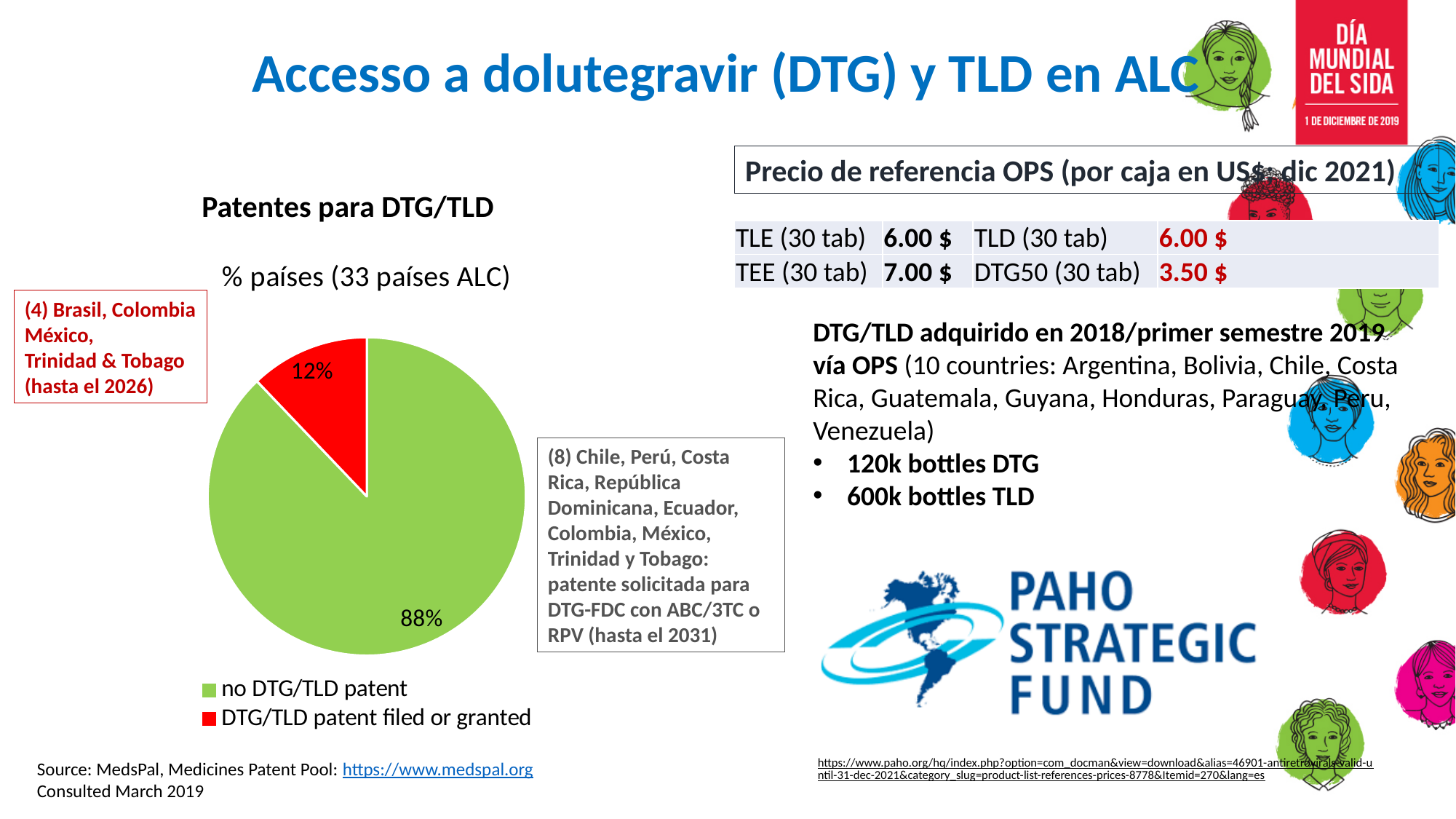
What share of the pie does the 'DTG/TLD patent filed or granted' slice represent? 12% What is the difference in percentage points between the 'no DTG/TLD patent' slice and the 'DTG/TLD patent filed or granted' slice? 76 What colour is the 'DTG/TLD patent filed or granted' slice in the pie chart? red What kind of chart is shown under the heading 'Patentes para DTG/TLD'? pie chart How many slices does the pie chart have? 2 Which is larger in the pie chart: 'no DTG/TLD patent' or 'DTG/TLD patent filed or granted'? no DTG/TLD patent Which slice of the pie chart is the largest? no DTG/TLD patent What percentage of countries have no DTG/TLD patent according to the pie chart? 88% What percentage of countries have a DTG/TLD patent filed or granted according to the pie chart? 12% Which slice of the pie chart is the smallest? DTG/TLD patent filed or granted How many entries does the pie chart legend list? 2 What colour is the 'no DTG/TLD patent' slice in the pie chart? green